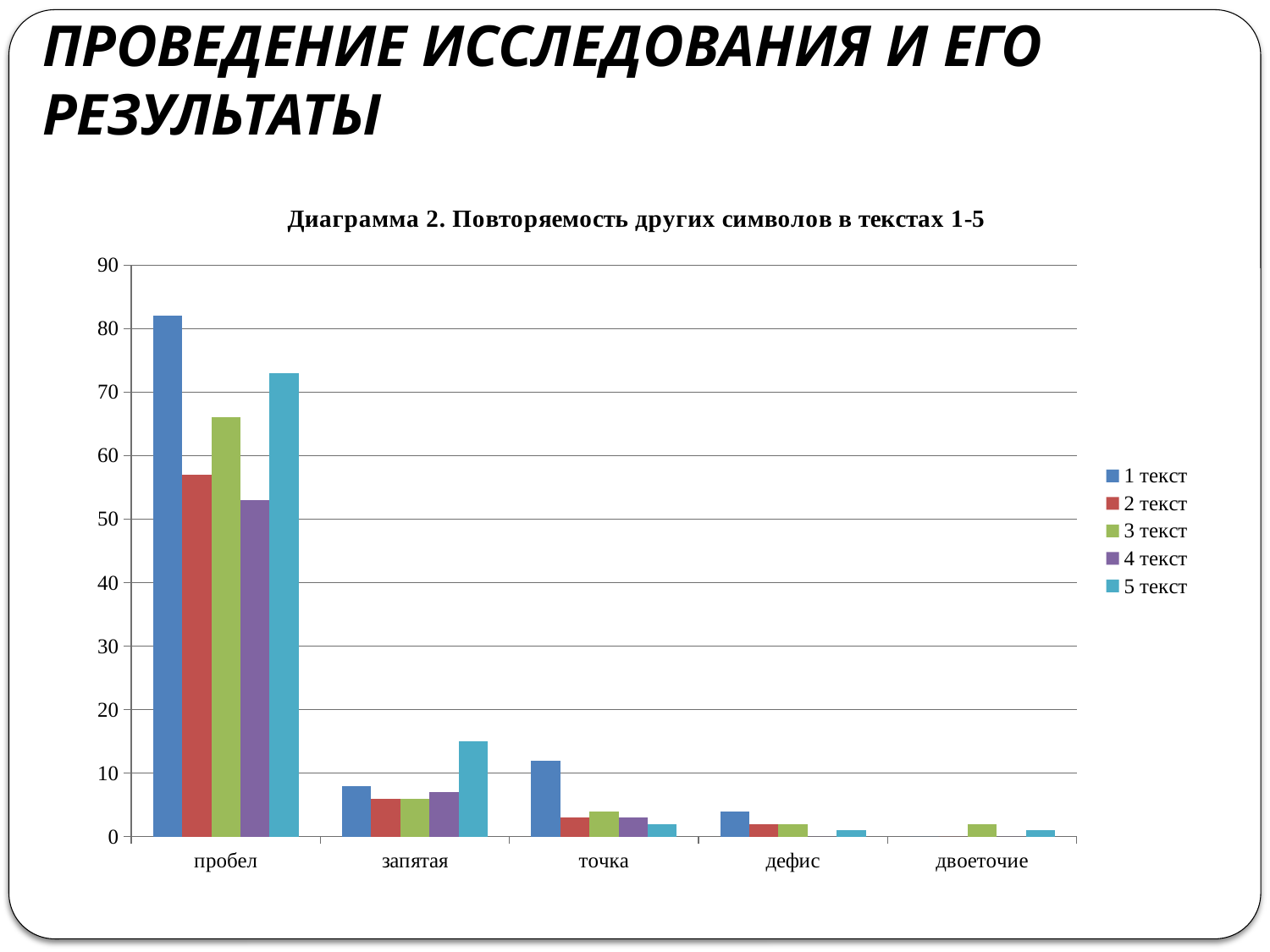
How many series does the legend list? 5 Is the value for 5 текст in пробел greater or less than 70? greater Which series has the lowest value for пробел? 4 текст Which category has the highest values across all series? пробел What is the title of the chart? Диаграмма 2. Повторяемость других символов в текстах 1-5 Is the value for 2 текст in пробел greater or less than 60? less Which series has the highest value for запятая? 5 текст Which is larger for точка: 1 текст or 2 текст? 1 текст How many categories are shown on the x axis? 5 Which series has the highest value for пробел? 1 текст Is the value for 1 текст in пробел greater or less than 80? greater What kind of chart is shown on the slide? bar chart